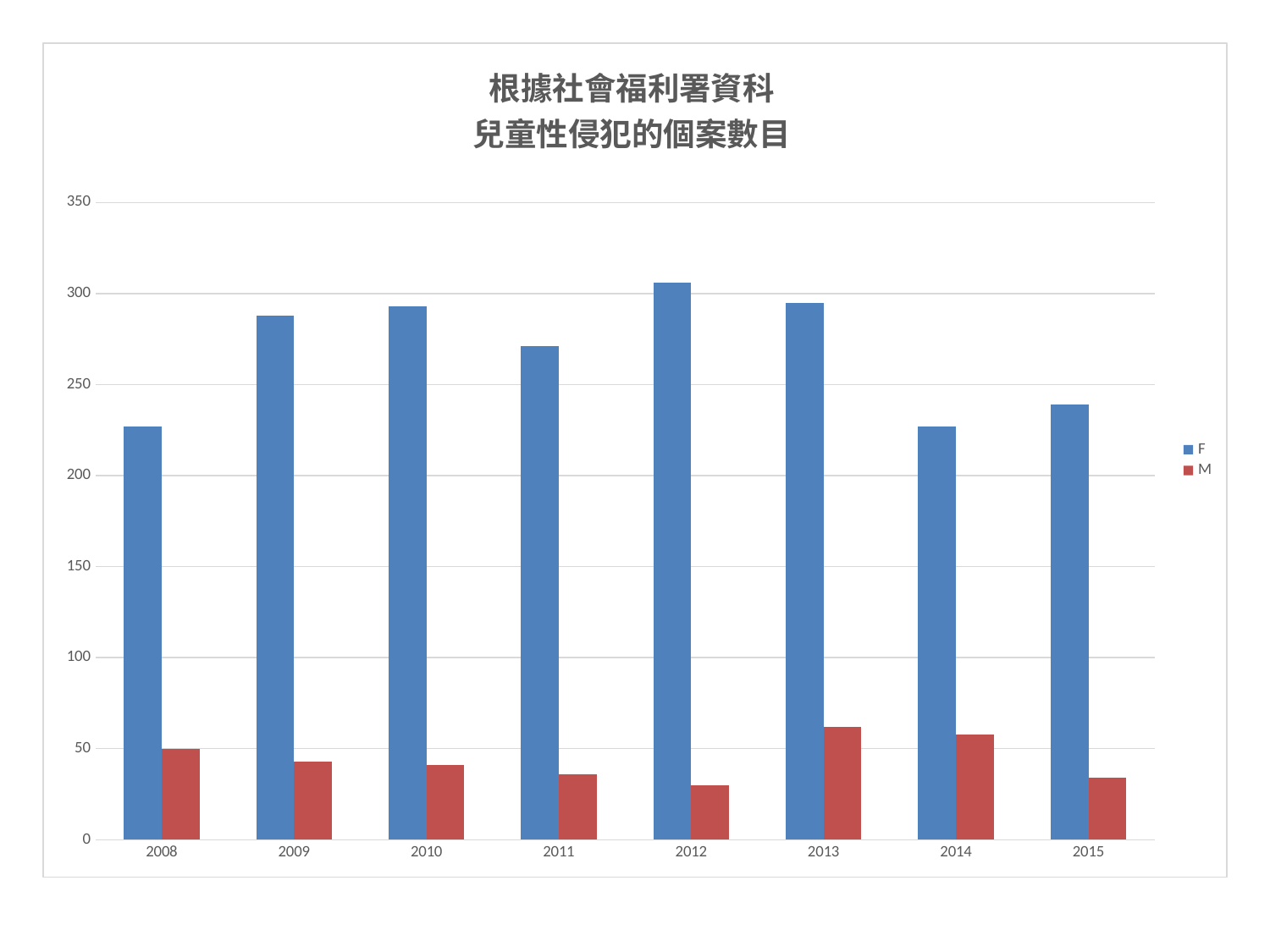
Which year has the highest value for the F series? 2012 Is the value for F in 2015 greater or less than 250? less What kind of chart is shown on the slide? bar chart Does the F series rise or fall from 2012 to 2014? fall Which is larger, the M value for 2013 or the M value for 2012? 2013 Is the value for F in 2012 greater or less than 300? greater Is the value for F in 2011 greater or less than 300? less How many series does the legend list? 2 How many years are shown on the x axis? 8 Which is larger, the F value for 2010 or the F value for 2011? 2010